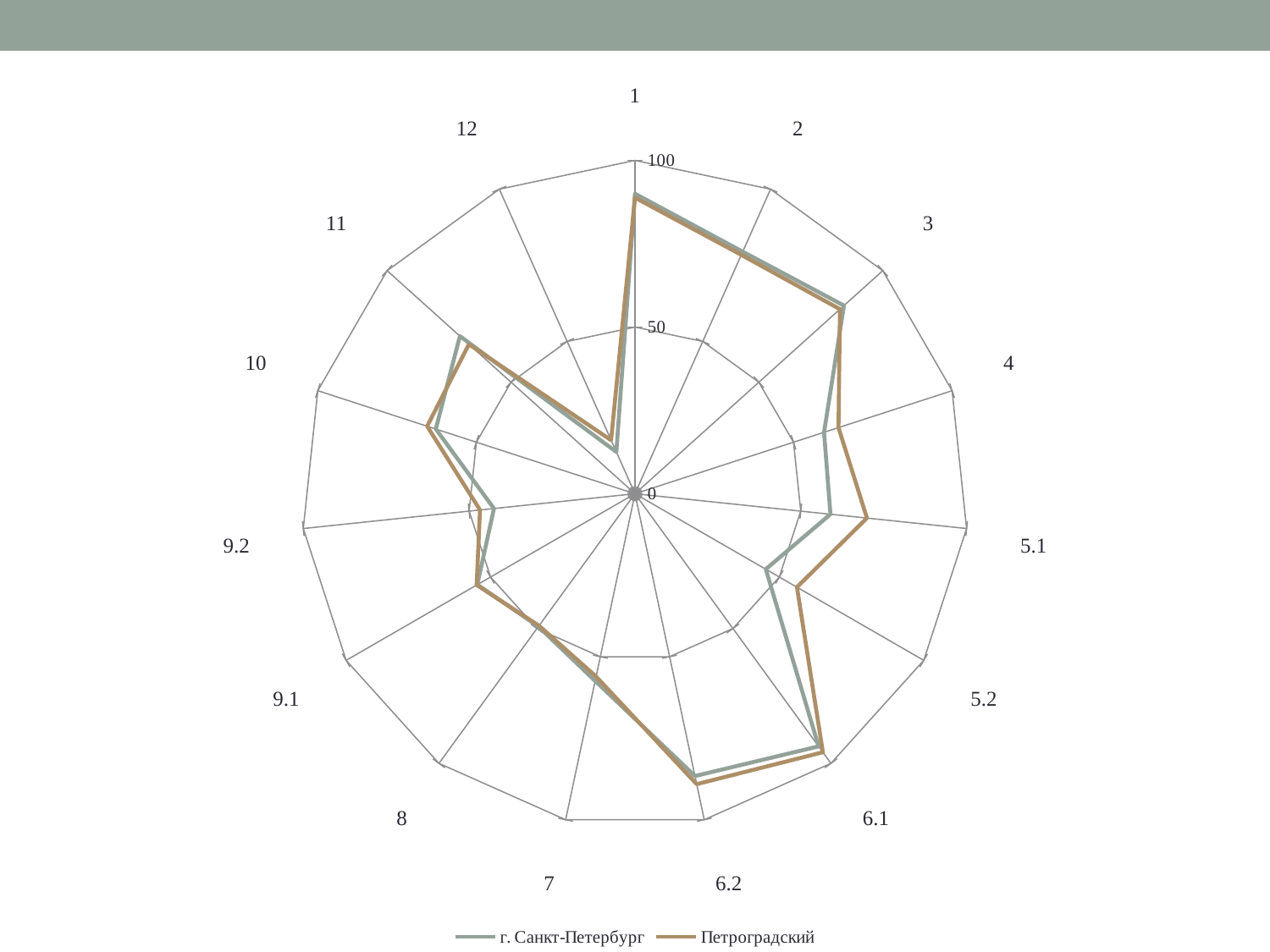
Is the value for category 10 for Петроградский greater or less than 50? greater Is the value for category 12 for Петроградский greater or less than 50? less Is the value for category 3 for г. Санкт-Петербург greater or less than 50? greater Which category has the lowest values for both series? 12 What are the two series named in the legend? г. Санкт-Петербург and Петроградский For category 5.1, which series has the larger value: г. Санкт-Петербург or Петроградский? Петроградский What kind of chart is shown on the slide? Radar chart What is the maximum value shown on the radial axis? 100 How many categories (axes) does the radar chart have? 15 How many series does the legend list? 2